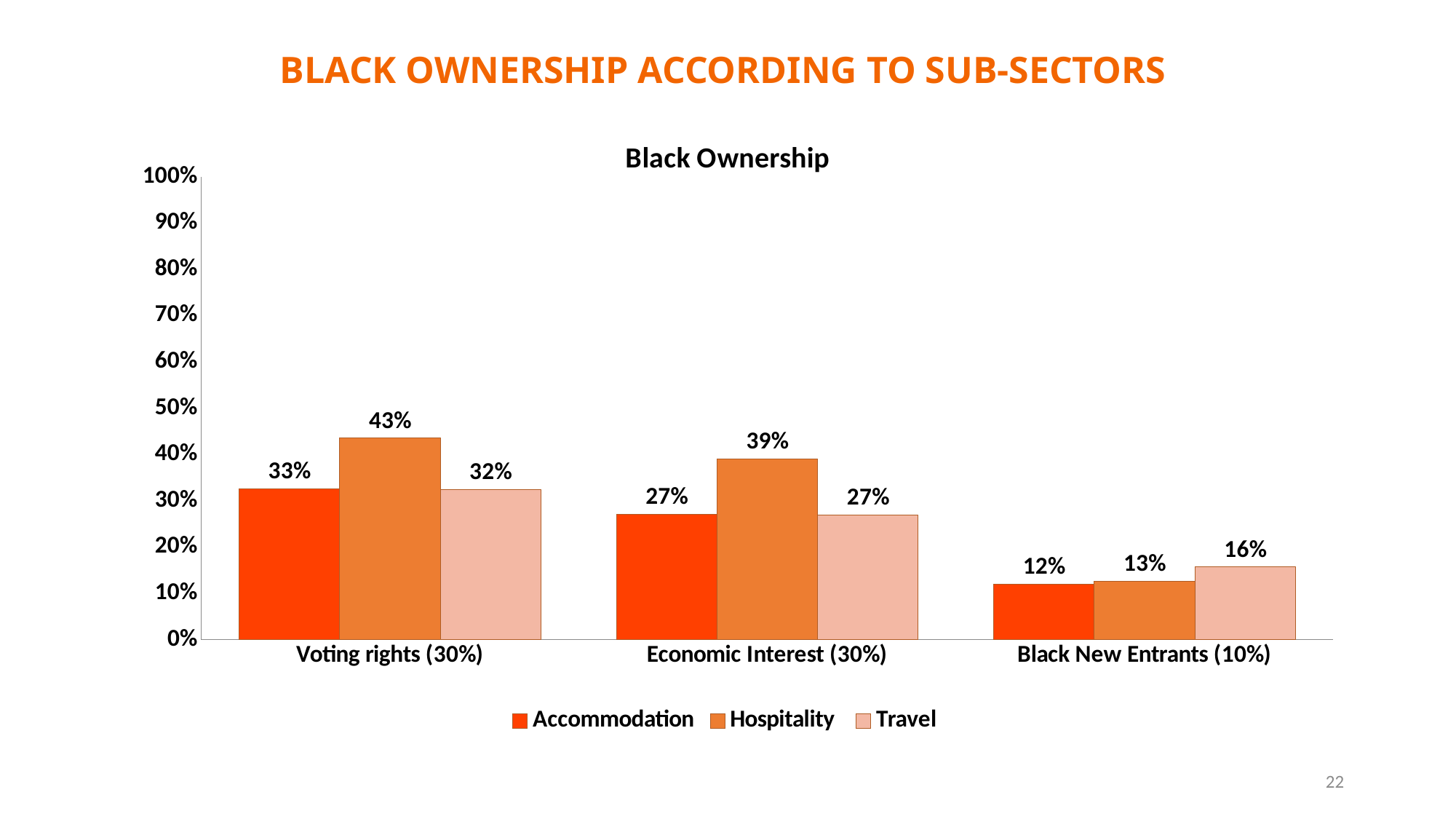
What is the title of the chart? Black Ownership What is the Accommodation value for Economic Interest (30%)? 27% What is the Travel value for Black New Entrants (10%)? 16% What is the Hospitality value for Voting rights (30%)? 43% Which category has the lowest Accommodation value? Black New Entrants (10%) Which series has the highest value for Economic Interest (30%)? Hospitality How many categories are shown on the x axis? 3 Which is larger: the Travel value for Black New Entrants (10%) or the Accommodation value for Black New Entrants (10%)? Travel How many series does the legend list? 3 What is the difference between the Hospitality and Accommodation values for Voting rights (30%)? 10% Is the Hospitality value for Economic Interest (30%) greater or less than 50%? less What kind of chart is shown? bar chart